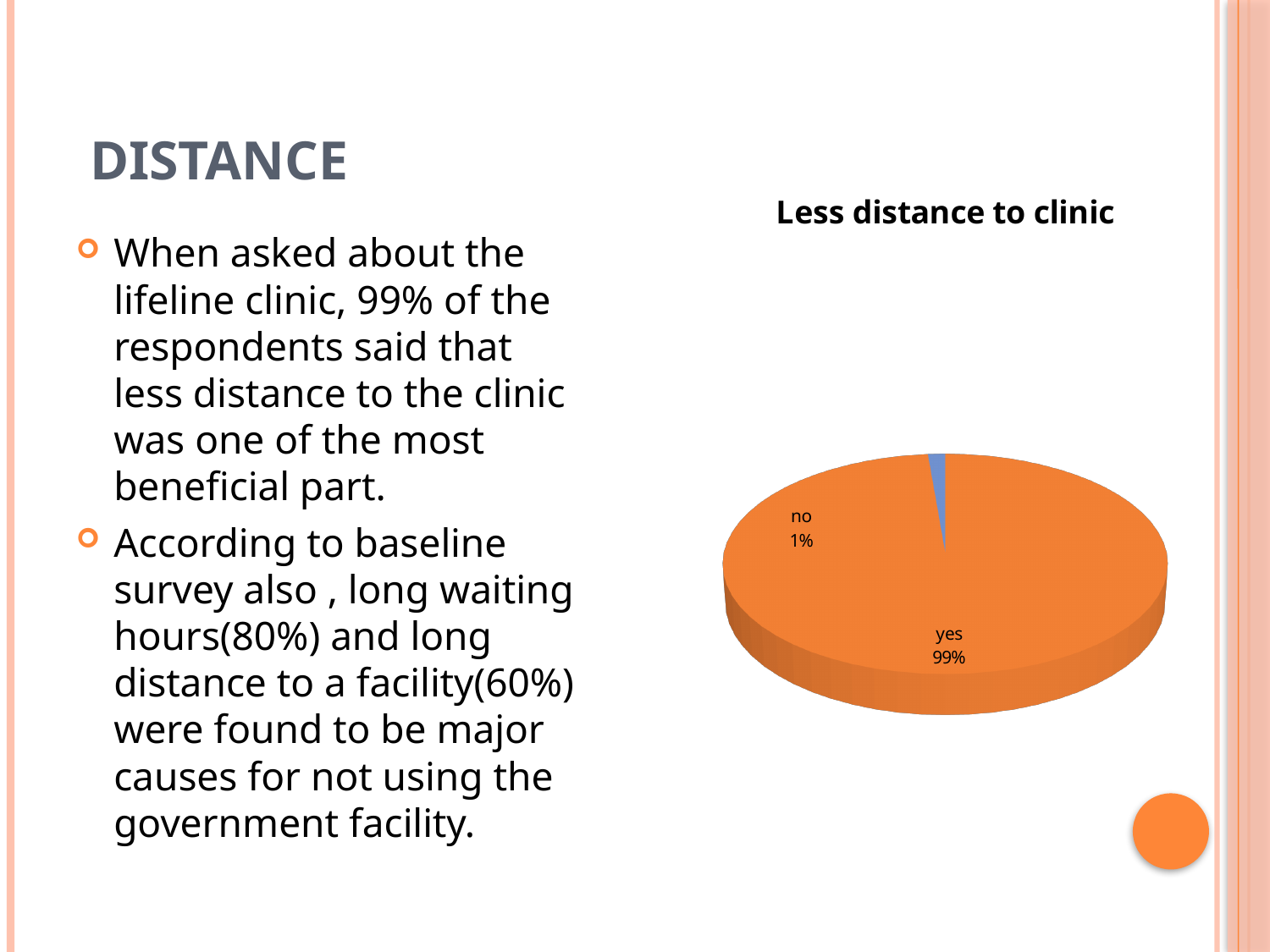
What is the difference in percentage points between the "yes" and "no" slices? 98 What colour is the "yes" slice of the pie? orange What share of the pie does the "yes" slice represent? 99% Which slice is larger, "yes" or "no"? yes What is the title of the chart? Less distance to clinic What share of the pie does the "no" slice represent? 1% Which category has the smallest slice of the pie? no What kind of chart is shown on the slide? pie chart Which category has the largest slice of the pie? yes How many slices does the pie chart have? 2